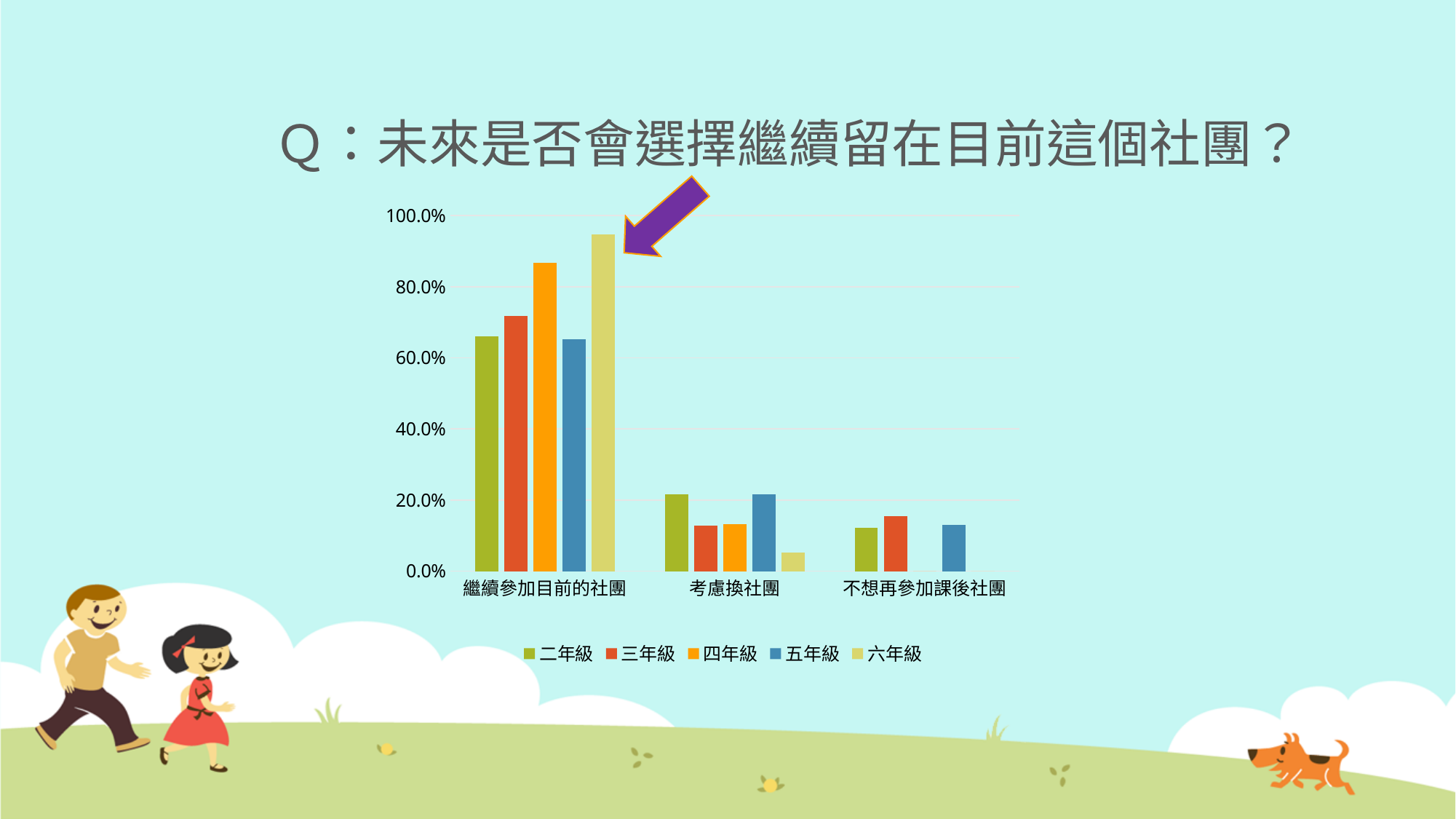
What kind of chart is shown on the slide? bar chart Is the value for 六年級 in 繼續參加目前的社團 greater or less than 80.0%? greater How many series does the chart's legend list? 5 Do the values for 六年級 rise or fall moving from 繼續參加目前的社團 to 不想再參加課後社團 along the x axis? fall Is the value for 三年級 in 不想再參加課後社團 greater or less than 20.0%? less Which series has the lowest bar for 考慮換社團? 六年級 Which series is shown in blue in the chart's legend? 五年級 Which series has the highest bar for 繼續參加目前的社團? 六年級 Is the value for 二年級 in 繼續參加目前的社團 greater or less than 60.0%? greater For 繼續參加目前的社團, which is larger: the value for 四年級 or the value for 三年級? 四年級 How many categories are shown on the x axis of the chart? 3